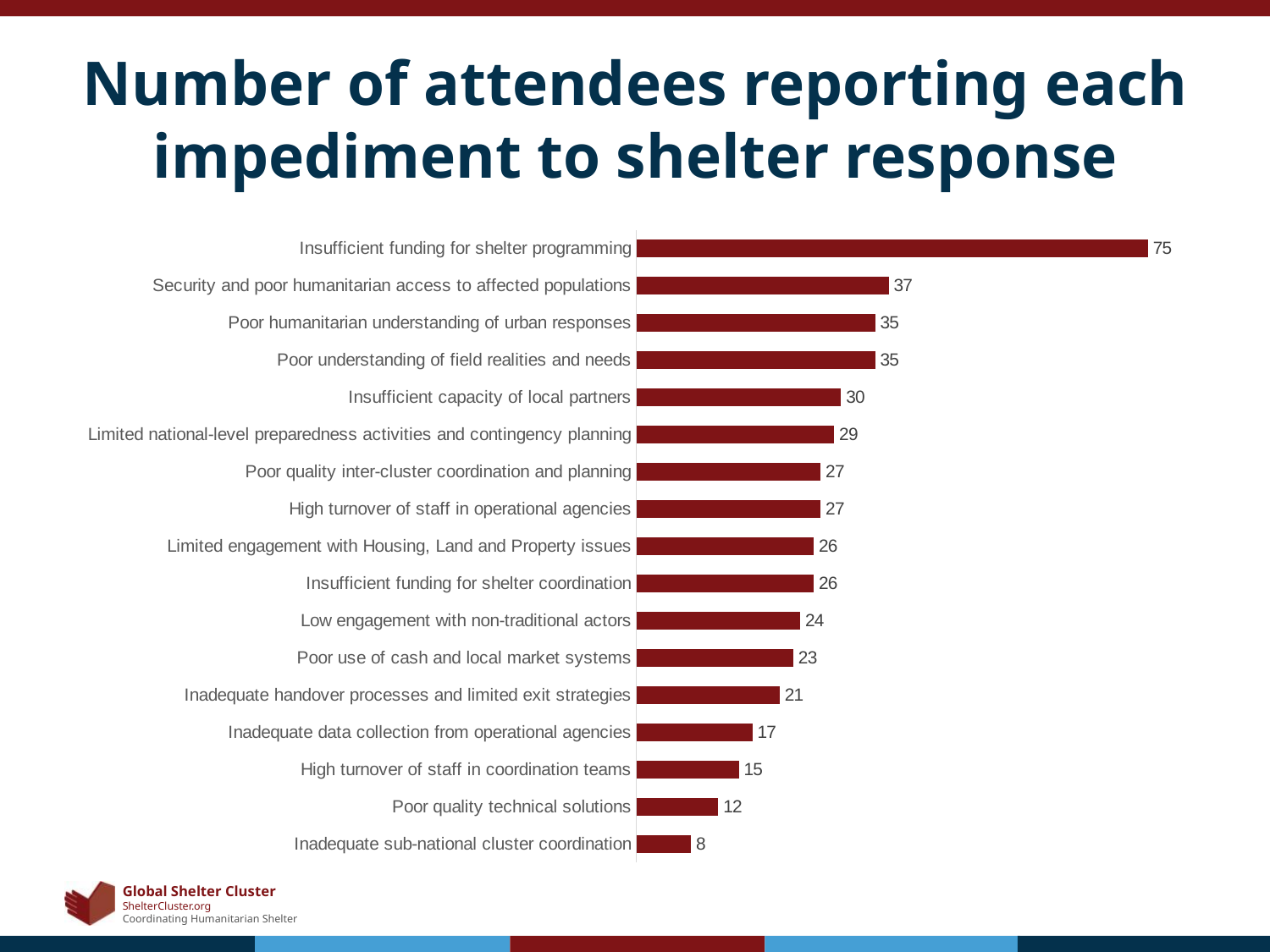
What is the difference between the number of attendees reporting 'Insufficient funding for shelter programming' and those reporting 'Security and poor humanitarian access to affected populations'? 38 What colour are the bars in the chart? Dark red What is the value for 'Poor use of cash and local market systems'? 23 What type of chart is shown on the slide? Bar chart How many attendees reported 'High turnover of staff in coordination teams'? 15 Which was reported by more attendees: 'Insufficient capacity of local partners' or 'Inadequate data collection from operational agencies'? Insufficient capacity of local partners How many impediments are listed in the chart? 17 Which impediment was reported by the fewest attendees? Inadequate sub-national cluster coordination How many attendees reported insufficient funding for shelter programming as an impediment? 75 What is the title of the slide? Number of attendees reporting each impediment to shelter response What is the difference between the values for 'Poor quality technical solutions' and 'Inadequate sub-national cluster coordination'? 4 Which impediment was reported by the most attendees? Insufficient funding for shelter programming